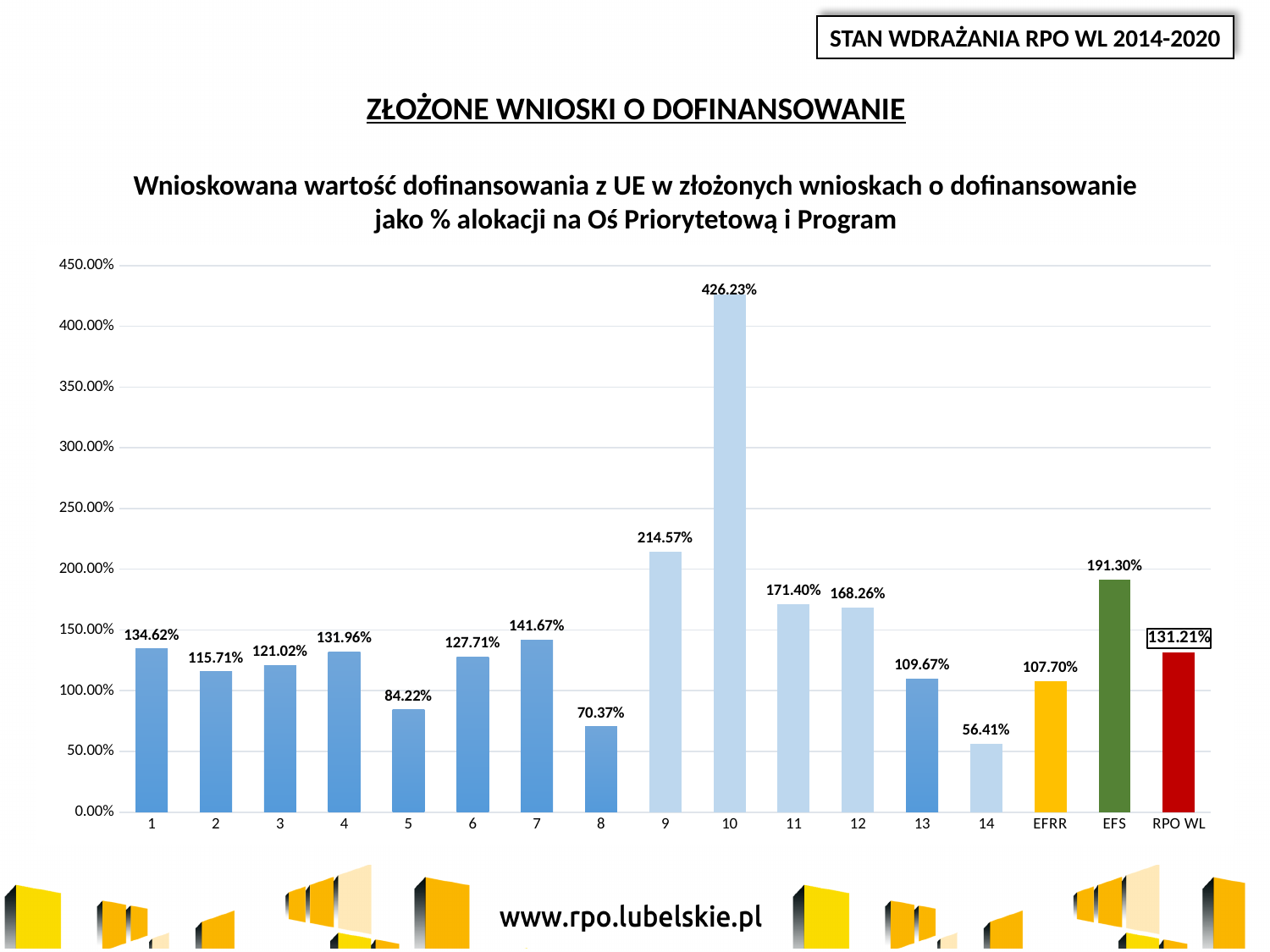
Which is larger, the value for category 11 or category 12? 11 What is the value for category 5? 84.22% Which category has the highest value? 10 What is the value for category 10? 426.23% What is the difference between the values for EFS and EFRR? 83.60% What colour is the bar for RPO WL? red What is the value for EFS? 191.30% What kind of chart is shown on the slide? bar chart Which category has the lowest value? 14 What is the value for RPO WL? 131.21% How many categories are shown on the x axis? 17 Is the value for category 9 greater or less than 200.00%? greater